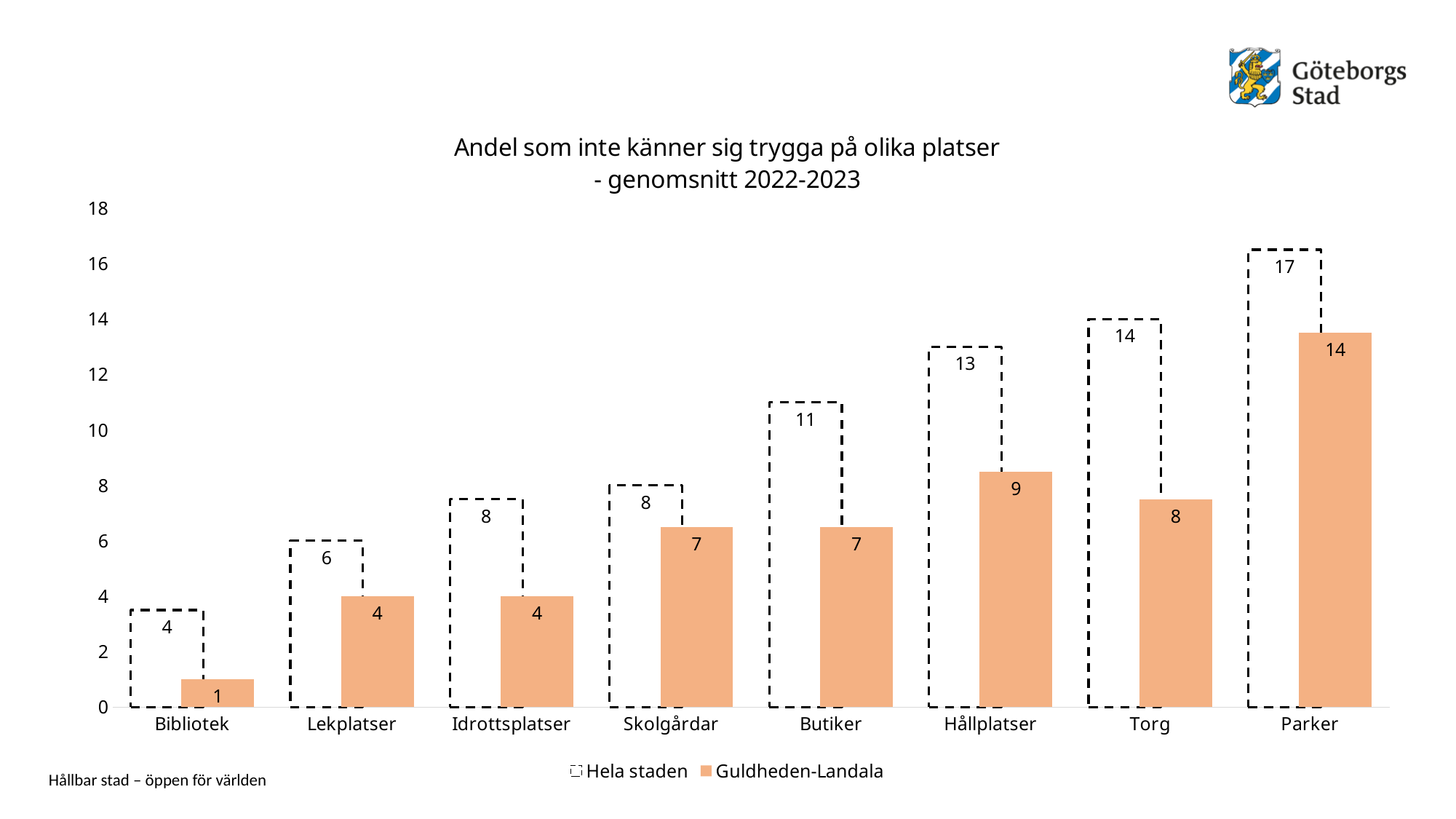
What is the difference between Hela staden and Guldheden-Landala at Torg? 6 What kind of chart is shown on the slide? Bar chart What is the value for Guldheden-Landala at Bibliotek? 1 Which category has the highest value for Guldheden-Landala? Parker Which category has the lowest value for Hela staden? Bibliotek What is the value for Hela staden at Parker? 17 Which is larger at Skolgårdar: Hela staden or Guldheden-Landala? Hela staden How many series does the legend list? 2 Which series is drawn with dashed outlines? Hela staden What is the value for Hela staden at Butiker? 11 What is the value for Guldheden-Landala at Hållplatser? 9 How many categories are shown on the x axis? 8